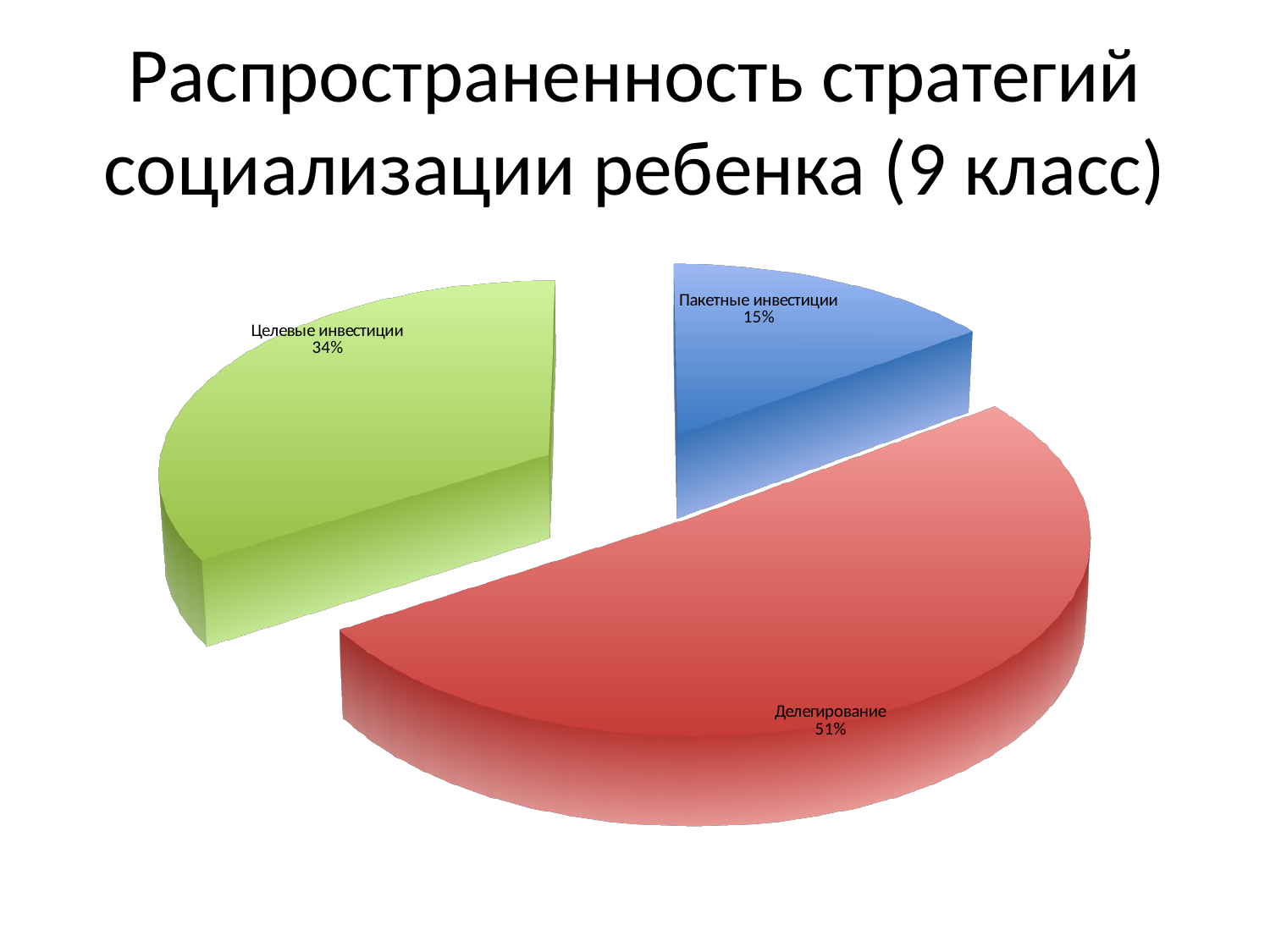
How many slices does the pie chart have? 3 What is the difference in percentage points between Целевые инвестиции and Пакетные инвестиции? 19 Which category has the smallest share of the pie? Пакетные инвестиции What is the title of the chart on the slide? Распространенность стратегий социализации ребенка (9 класс) What share of the pie does Целевые инвестиции have? 34% What share of the pie does Делегирование have? 51% Which is larger, the share for Целевые инвестиции or the share for Пакетные инвестиции? Целевые инвестиции Which category has the largest share of the pie? Делегирование What colour is the slice for Делегирование? Red What is the difference in percentage points between Делегирование and Целевые инвестиции? 17 What kind of chart is shown on the slide? Pie chart What share of the pie does Пакетные инвестиции have? 15%